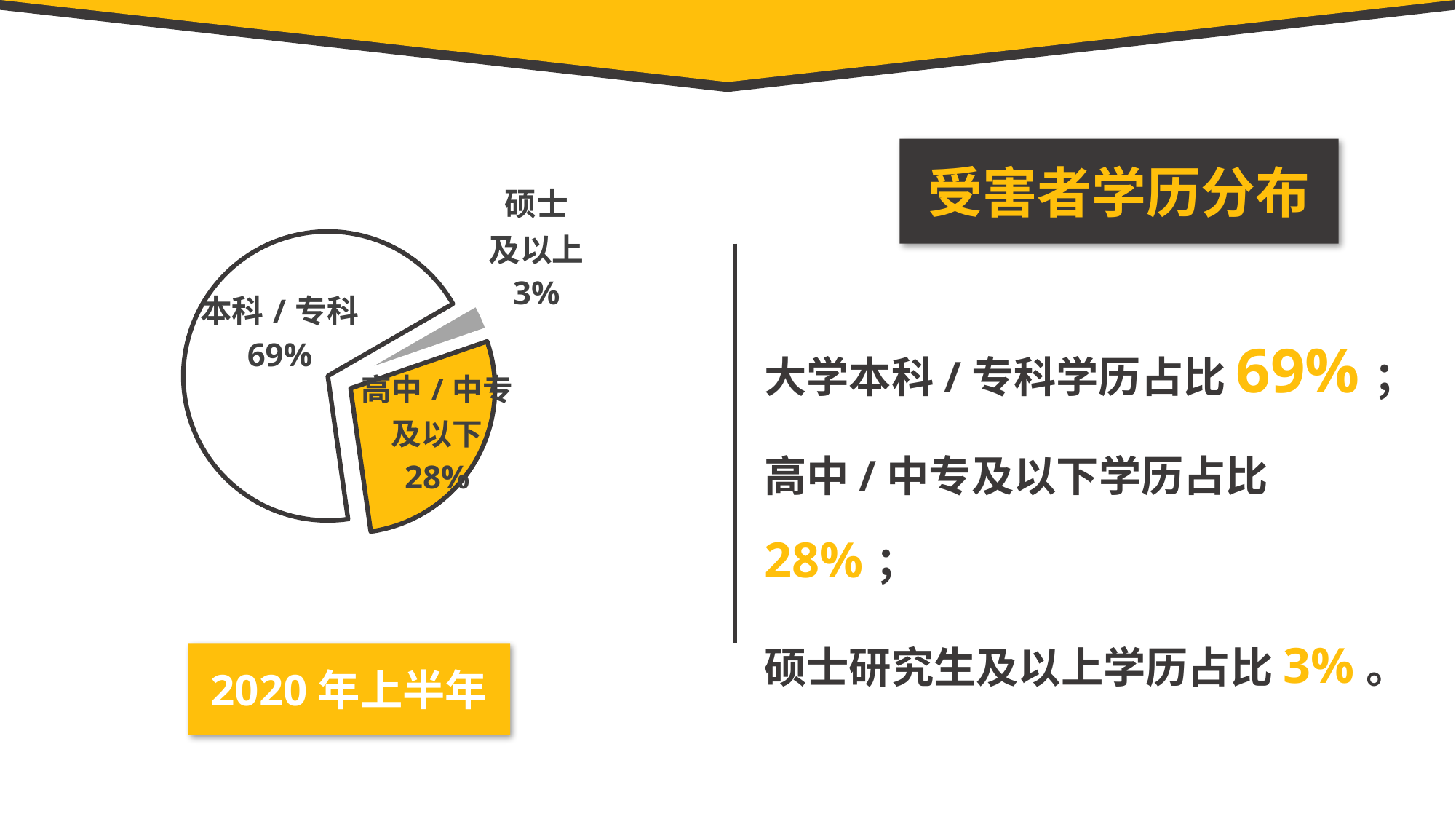
What kind of chart is shown on the slide? pie chart Which is larger, the share for 高中 / 中专及以下 or the share for 硕士及以上? 高中 / 中专及以下 What share of the pie does 高中 / 中专及以下 represent? 28% What is the title of the chart shown on the slide? 受害者学历分布 What share of the pie does 硕士及以上 represent? 3% Which category has the smallest slice of the pie? 硕士及以上 What share of the pie does 本科 / 专科 represent? 69% Which category has the largest slice of the pie? 本科 / 专科 How many slices does the pie chart have? 3 Which slice of the pie is coloured yellow? 高中 / 中专及以下 What is the difference in percentage points between 高中 / 中专及以下 and 硕士及以上? 25 What is the difference in percentage points between 本科 / 专科 and 高中 / 中专及以下? 41